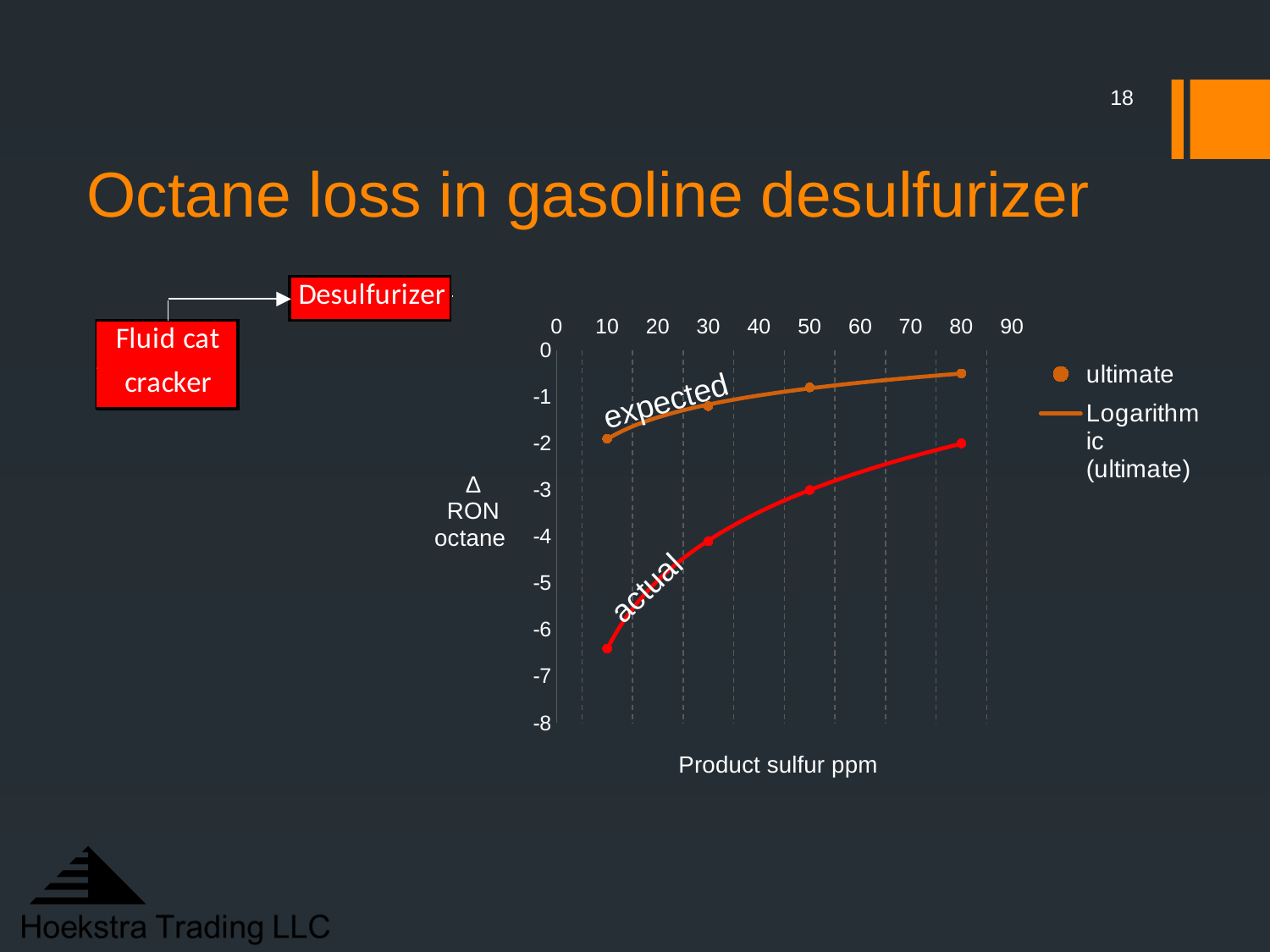
Is the 'expected' value at 80 ppm product sulfur greater or less than -1? greater What is the x-axis label of the chart? Product sulfur ppm Is the 'actual' value at 10 ppm product sulfur greater or less than -6? less What kind of chart is shown on the slide? line chart How many entries does the chart legend list? 2 At 10 ppm product sulfur, which curve has the higher ΔRON octane value, 'expected' or 'actual'? expected How many data points are plotted on the 'actual' curve? 4 Do the values on the 'actual' curve rise or fall as product sulfur ppm increases? rise Is the 'actual' value at 30 ppm product sulfur greater or less than -5? greater What colour is the 'actual' curve on the chart? red At which product sulfur level is the 'actual' ΔRON octane value lowest? 10